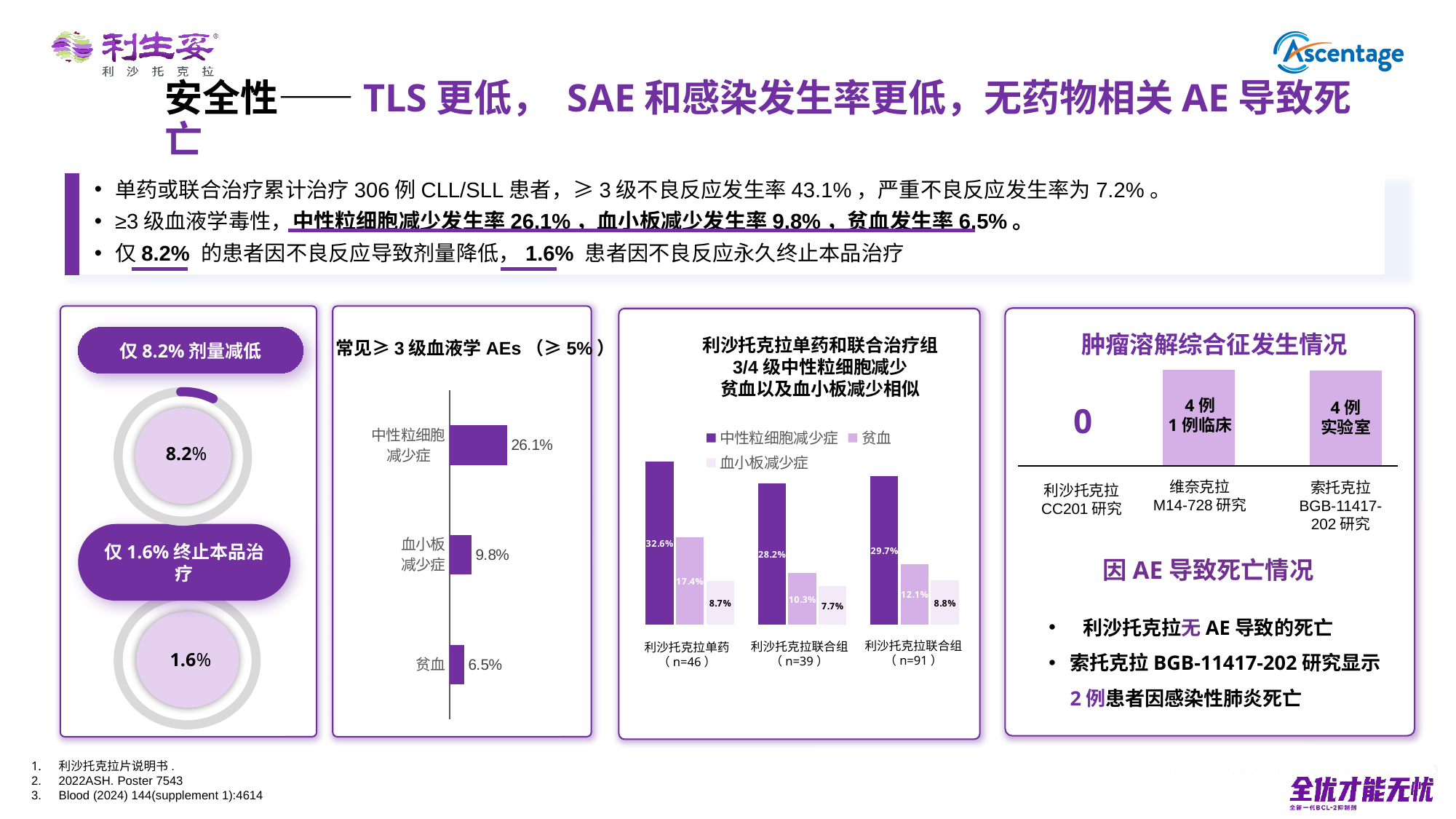
In the chart titled 常见≥3级血液学AEs（≥5%）, what is the difference between 中性粒细胞减少症 and 血小板减少症? 16.3% In the grouped bar chart about 利沙托克拉单药和联合治疗组, how many series does the legend list? 3 In the grouped bar chart about 利沙托克拉单药和联合治疗组, is the 血小板减少症 value for 利沙托克拉联合组（n=39） larger or smaller than that for 利沙托克拉联合组（n=91）? smaller In the chart titled 常见≥3级血液学AEs（≥5%）, what is the value for 中性粒细胞减少症? 26.1% In the grouped bar chart about 利沙托克拉单药和联合治疗组, what is the 中性粒细胞减少症 value for 利沙托克拉单药（n=46）? 32.6% In the grouped bar chart about 利沙托克拉单药和联合治疗组, which group has the highest 中性粒细胞减少症 value? 利沙托克拉单药（n=46） In the chart titled 肿瘤溶解综合征发生情况, what is the value for 利沙托克拉 CC201研究? 0 In the grouped bar chart about 利沙托克拉单药和联合治疗组, what is the 贫血 value for 利沙托克拉联合组（n=91）? 12.1% What kind of chart is the one titled 常见≥3级血液学AEs（≥5%）? bar chart In the chart titled 常见≥3级血液学AEs（≥5%）, which category has the lowest value? 贫血 In the chart titled 常见≥3级血液学AEs（≥5%）, what is the value for 贫血? 6.5% In the chart titled 肿瘤溶解综合征发生情况, how many studies are shown on the x axis? 3